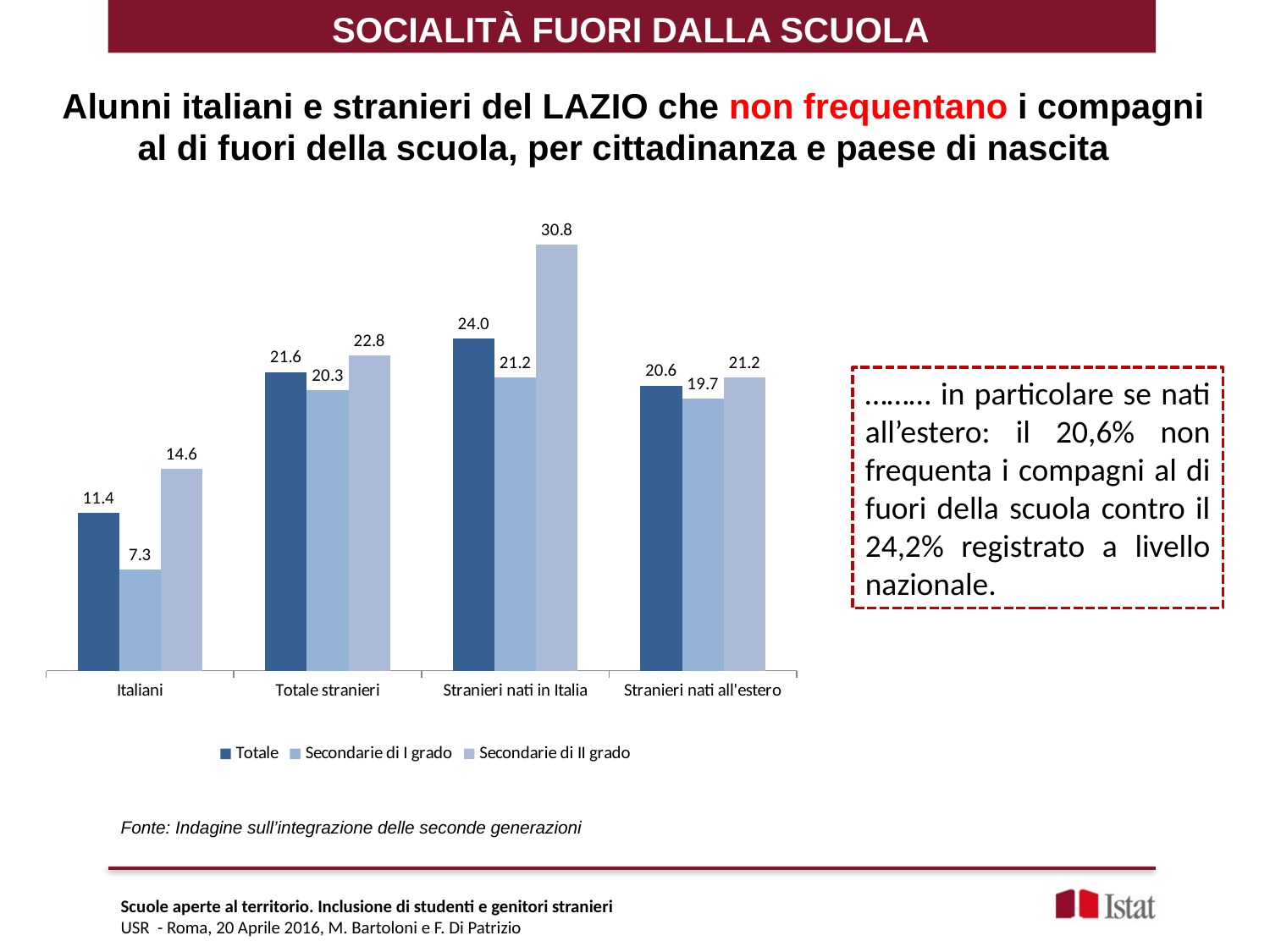
Which category has the lowest Secondarie di I grado value? Italiani How many categories are shown on the x axis? 4 What kind of chart is shown on the slide? Bar chart What is the Totale value for Italiani? 11.4 Which is larger: the Totale value for Totale stranieri or the Totale value for Stranieri nati all'estero? Totale stranieri What is the Secondarie di I grado value for Stranieri nati all'estero? 19.7 What is the name of the third series in the legend? Secondarie di II grado How many series does the legend list? 3 What is the difference between the Secondarie di II grado value and the Secondarie di I grado value for Italiani? 7.3 What is the difference between the Secondarie di II grado value for Stranieri nati in Italia and for Totale stranieri? 8.0 Which category has the highest Totale value? Stranieri nati in Italia What is the Secondarie di II grado value for Stranieri nati in Italia? 30.8